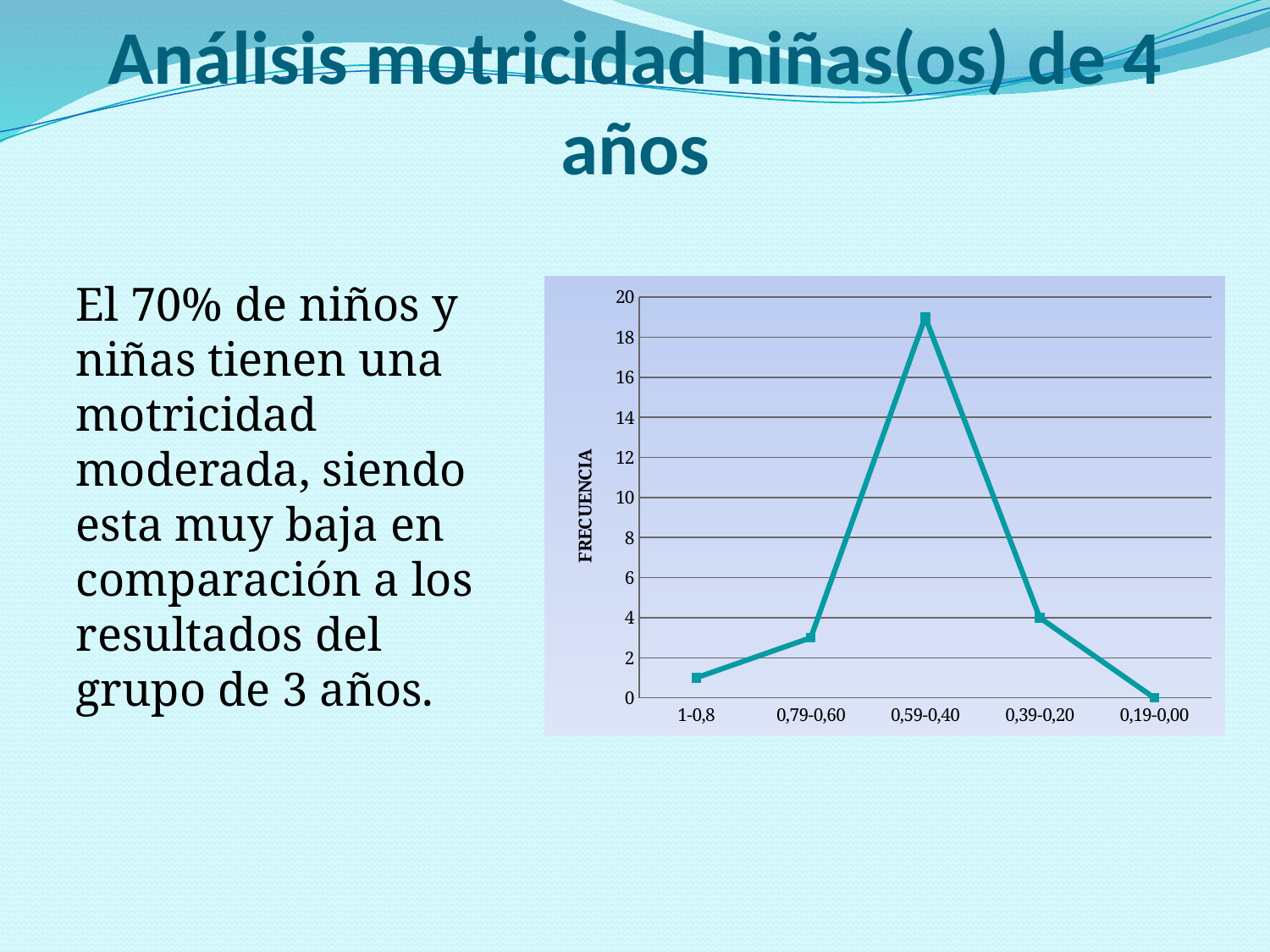
Is the value for 0,59-0,40 greater or less than 18? greater Which category has the lowest frequency in the chart? 0,19-0,00 Which category has the highest frequency in the chart? 0,59-0,40 What is the frequency for the category 0,19-0,00? 0 What is the frequency for the category 0,39-0,20? 4 Which has a higher frequency, 0,79-0,60 or 0,39-0,20? 0,39-0,20 What kind of chart is shown on the slide? line chart Is the value for 1-0,8 greater or less than 2? less Do the values rise or fall from 0,59-0,40 to 0,19-0,00? fall Is the value for 0,79-0,60 greater or less than 4? less How many categories are shown on the x axis of the chart? 5 What is the label on the vertical axis of the chart? FRECUENCIA